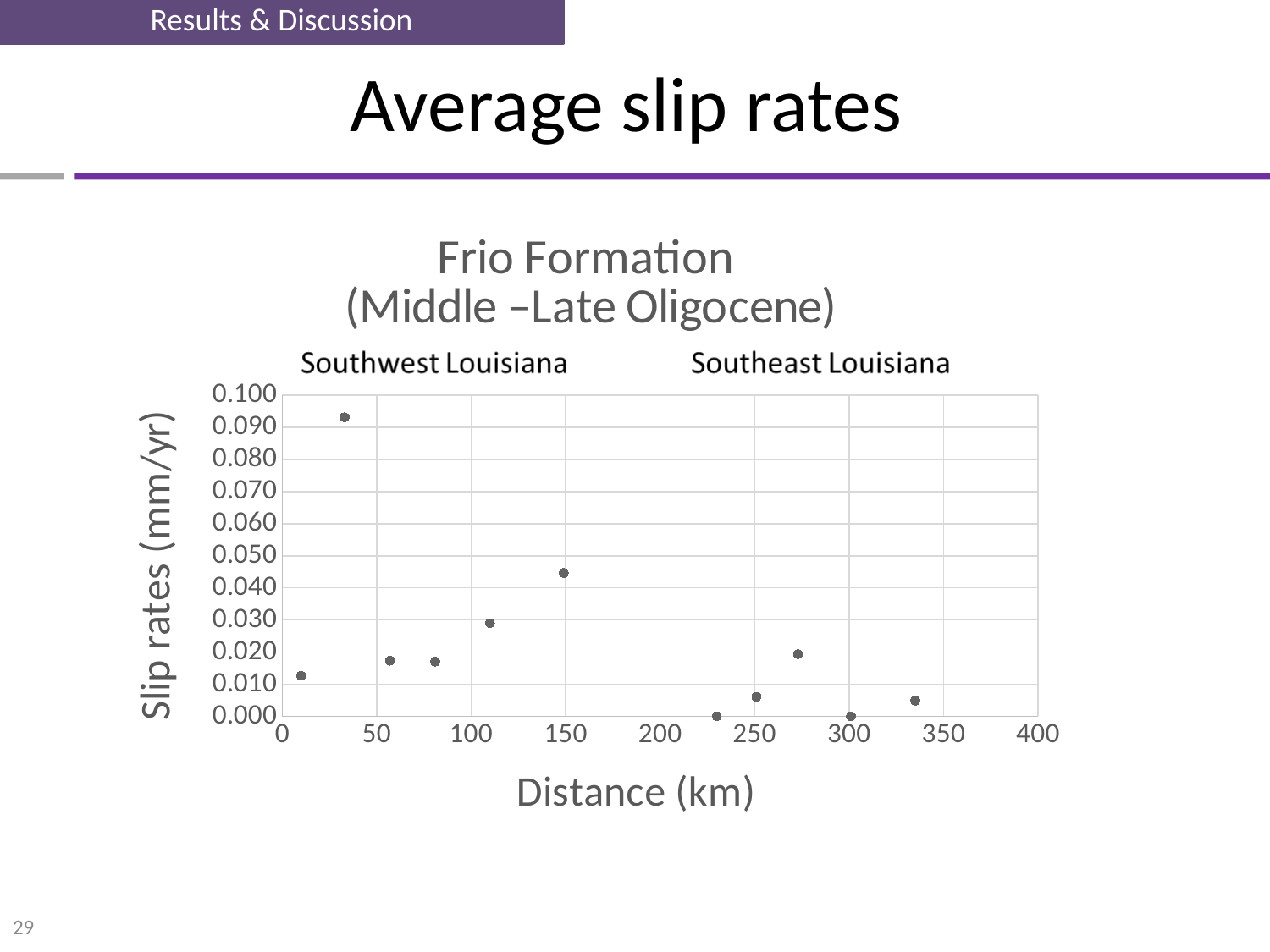
How many data points are plotted on the chart? 11 What is the title of the chart? Frio Formation (Middle –Late Oligocene) Which has the higher slip rate: the data point near 150 km or the data point near 110 km? The point near 150 km What is the label of the y axis of the chart? Slip rates (mm/yr) What kind of chart is shown on the slide? Scatter chart Which region's data points generally show higher slip rates, Southwest Louisiana or Southeast Louisiana? Southwest Louisiana What is the maximum value shown on the x axis of the chart? 400 Is the slip rate of the data point near 250 km greater or less than 0.010 mm/yr? less Is the slip rate of the highest data point greater or less than 0.080 mm/yr? greater Is the slip rate of the data point near 150 km greater or less than 0.050 mm/yr? less